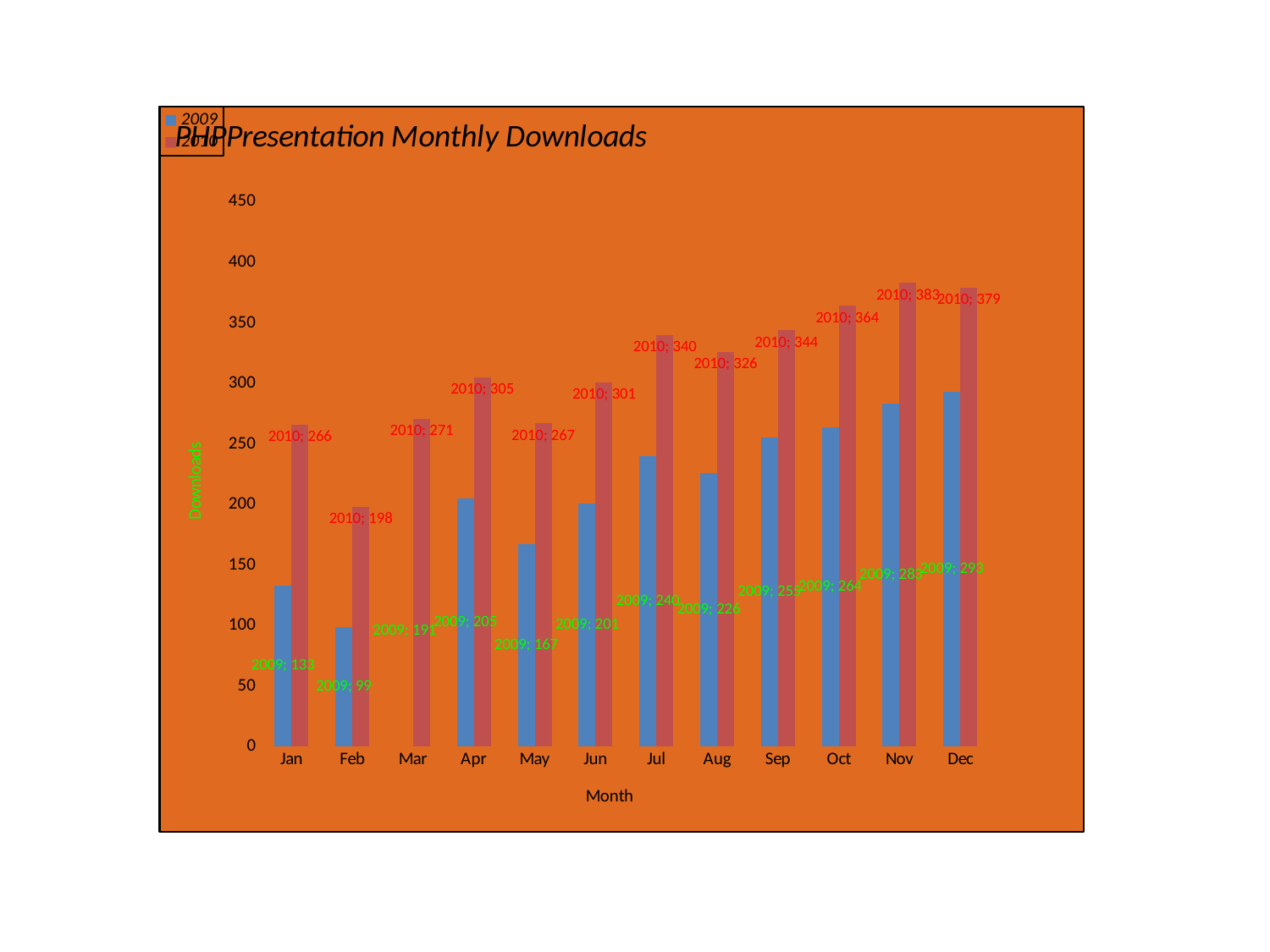
What is the value for 2010 in Jul? 340 Which month has the lowest value for the 2009 series? Feb What is the value for 2009 in Dec? 293 How many months are shown on the x axis? 12 Is the value for 2009 in Oct greater or less than 250? greater How many series does the legend list? 2 What is the value for 2009 in Feb? 99 Which month has the highest value for the 2010 series? Nov What kind of chart is shown on the slide? bar chart What is the value for 2010 in Nov? 383 What is the difference between the 2010 and 2009 values in Jul? 100 Which is larger, the 2010 value in Nov or the 2010 value in Dec? Nov